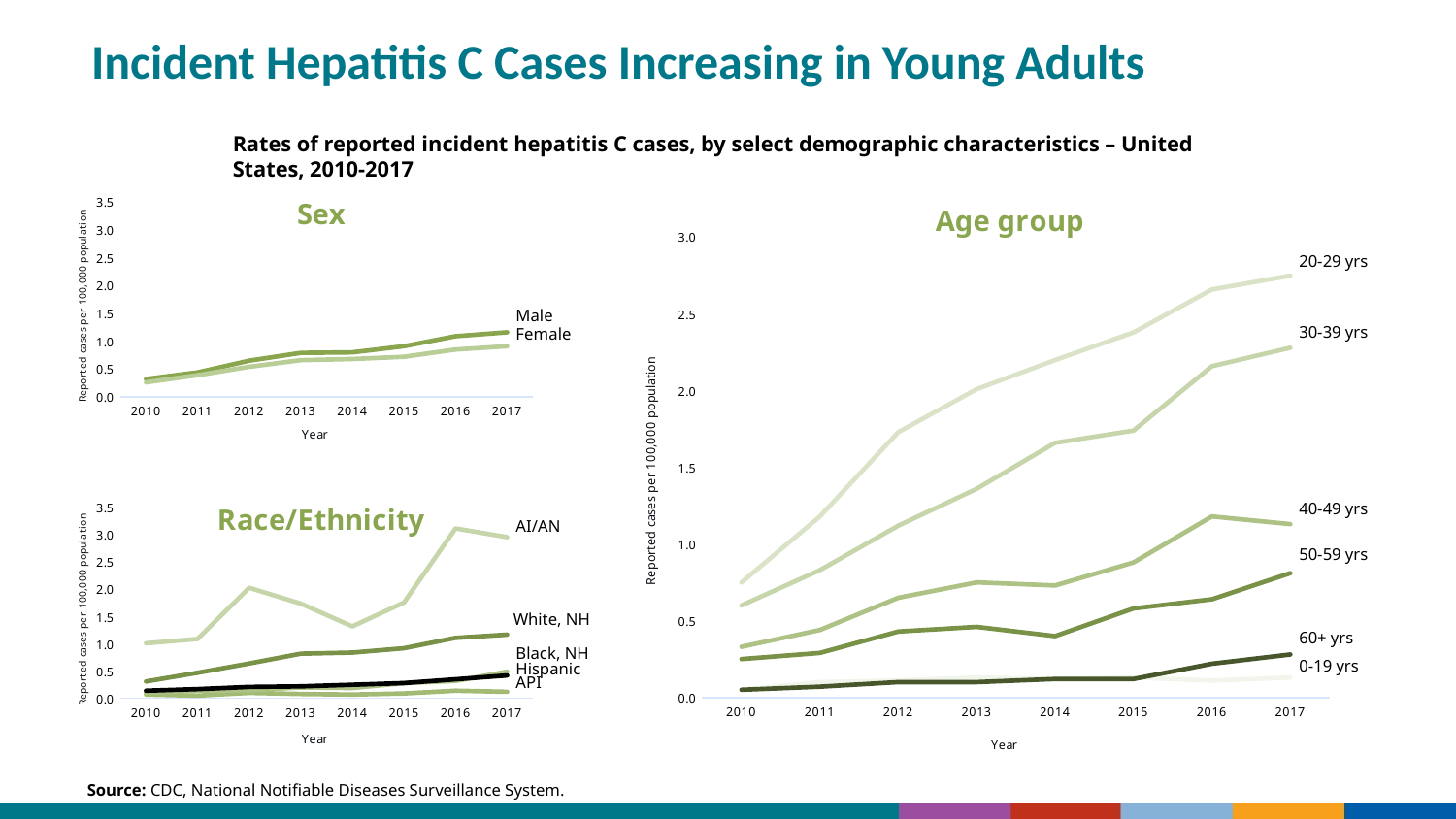
What kind of chart is the 'Age group' chart? line chart In the 'Race/Ethnicity' chart, is the value for AI/AN in 2014 greater or less than 1.0? greater How many series does the 'Age group' chart show? 6 In the 'Age group' chart, which age group has the highest value in 2017? 20-29 yrs How many series does the 'Race/Ethnicity' chart show? 5 How many years are plotted on the x axis of the 'Sex' chart? 8 In the 'Age group' chart, is the value for 20-29 yrs in 2017 greater or less than 2.5? greater In the 'Sex' chart, is the value for Male in 2017 greater or less than 1.0? greater In the 'Age group' chart, does the 20-29 yrs series rise or fall from 2010 to 2017? rise In the 'Sex' chart, which series has the higher value in 2017, Male or Female? Male In the 'Race/Ethnicity' chart, which series has the lowest value in 2017? API In the 'Race/Ethnicity' chart, which series has the highest value in 2017? AI/AN